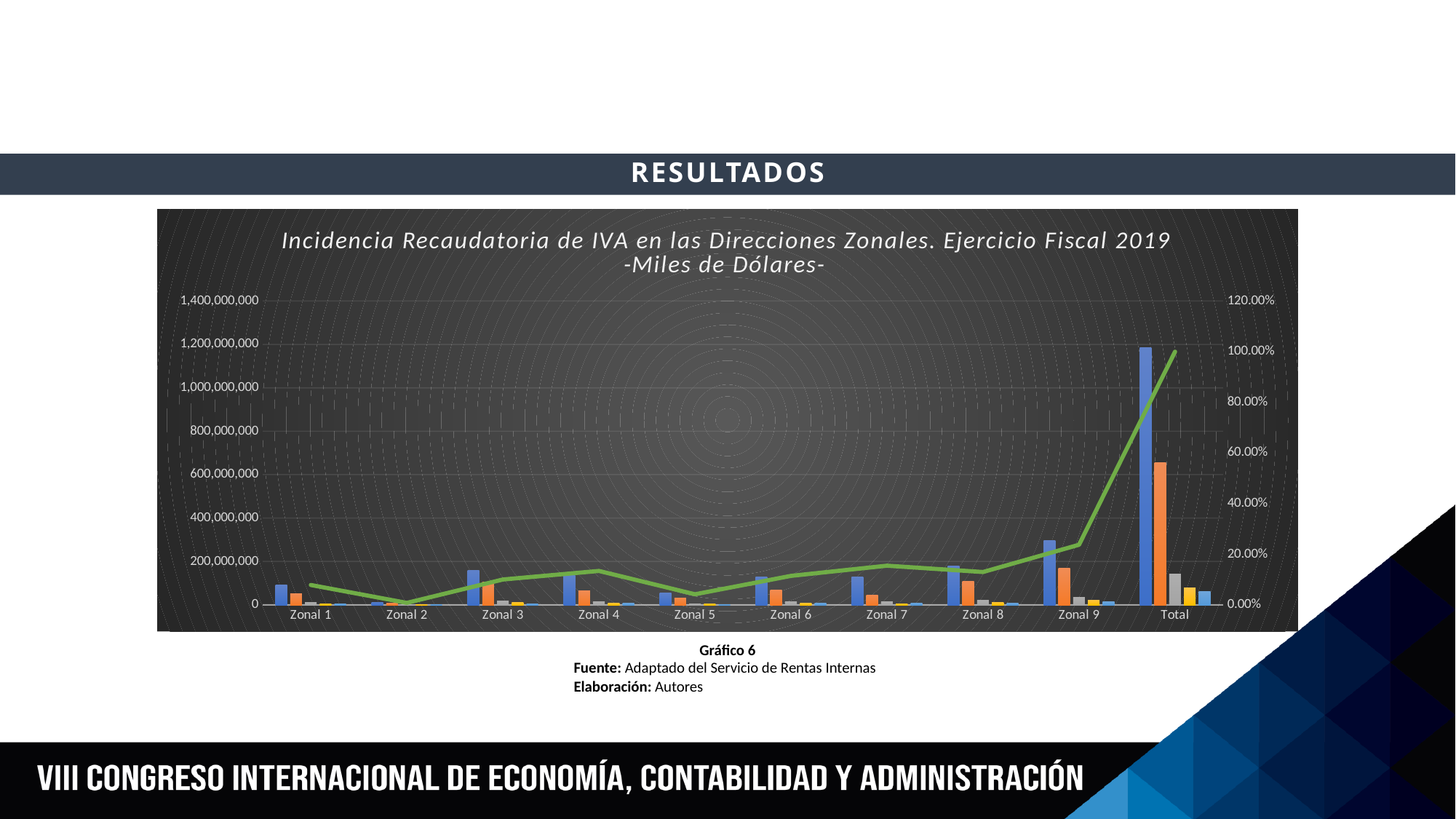
Is the blue bar for Total greater or less than 1,000,000,000? greater Does the green line rise or fall from Zonal 9 to Total? Rises Is the green line value for Total greater or less than 80.00%? greater Among the Zonal categories (Zonal 1 to Zonal 9), which has the tallest blue bar? Zonal 9 Among the Zonal categories (Zonal 1 to Zonal 9), which has the lowest blue bar? Zonal 2 Is the green line value for Zonal 2 greater or less than 20.00%? less Which has a taller blue bar, Zonal 9 or Zonal 1? Zonal 9 How many categories are shown along the x axis of the chart? 10 Which category has the tallest blue bar in the chart? Total What is the title of the chart? Incidencia Recaudatoria de IVA en las Direcciones Zonales. Ejercicio Fiscal 2019 -Miles de Dólares- What kind of chart is shown on the slide? A combined bar and line chart